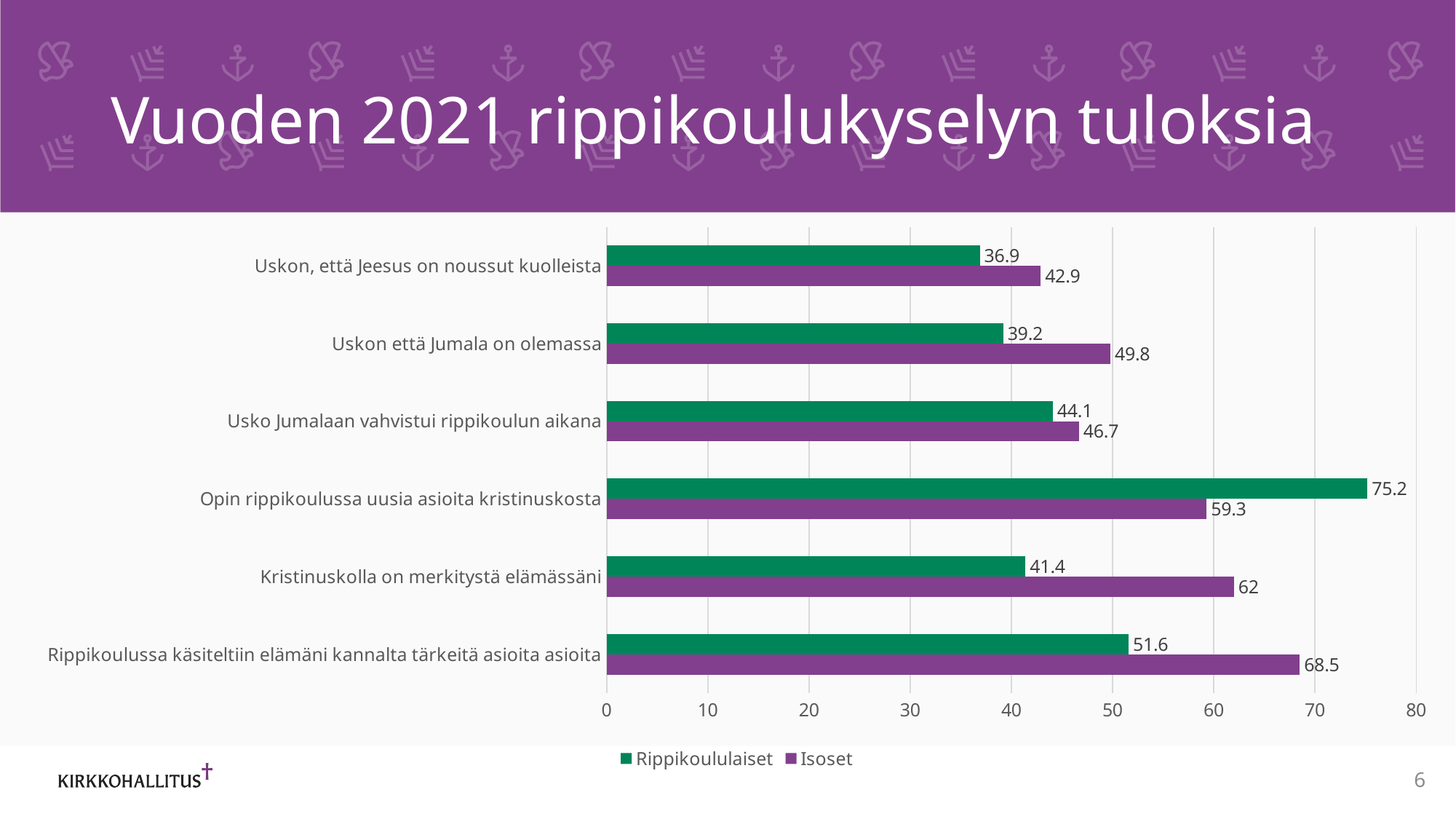
Is the Isoset value for "Kristinuskolla on merkitystä elämässäni" greater or less than 50? greater Which category has the highest Rippikoululaiset value? Opin rippikoulussa uusia asioita kristinuskosta Which category has the lowest Isoset value? Uskon, että Jeesus on noussut kuolleista What is the difference between the Isoset and Rippikoululaiset values for "Rippikoulussa käsiteltiin elämäni kannalta tärkeitä asioita asioita"? 16.9 For "Opin rippikoulussa uusia asioita kristinuskosta", which series has the larger value, Rippikoululaiset or Isoset? Rippikoululaiset How many categories are shown on the chart? 6 What is the Isoset value for "Uskon että Jumala on olemassa"? 49.8 What is the Rippikoululaiset value for "Opin rippikoulussa uusia asioita kristinuskosta"? 75.2 What is the Isoset value for "Kristinuskolla on merkitystä elämässäni"? 62 What kind of chart is shown on the slide? Bar chart How many series does the legend list? 2 Which colour represents the Isoset series? Purple